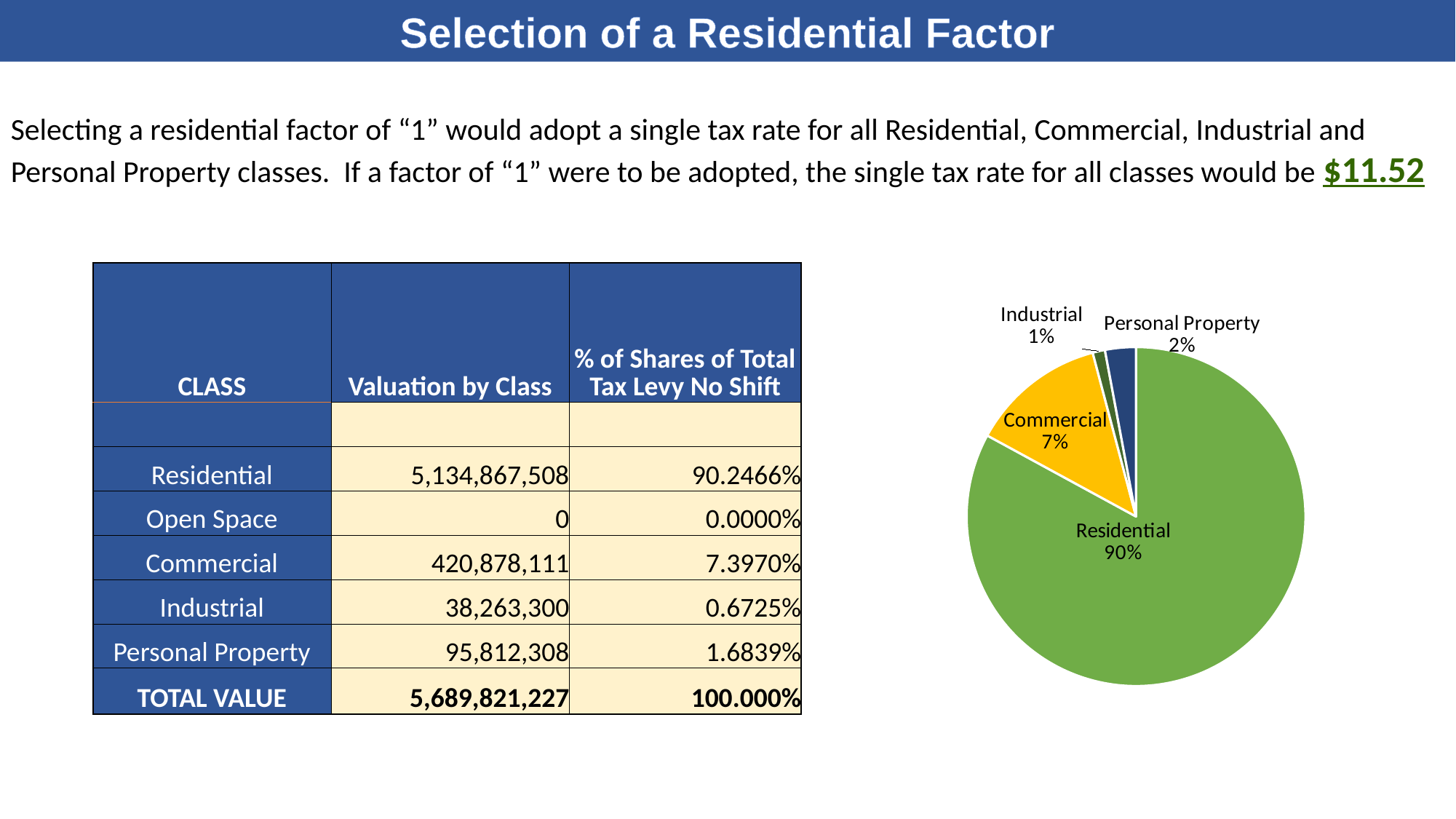
In the pie chart, what share does Personal Property have? 2% In the pie chart, what share does Residential have? 90% In the pie chart, what is the difference between the Residential share and the Commercial share? 83% What colour is the Commercial slice in the pie chart? yellow In the pie chart, which is larger, Commercial or Personal Property? Commercial In the pie chart, what share does Commercial have? 7% Which slice of the pie chart is the largest? Residential In the pie chart, what is the difference between the Personal Property share and the Industrial share? 1% What kind of chart is shown on the slide? pie chart Which slice of the pie chart is the smallest? Industrial How many labeled slices does the pie chart have? 4